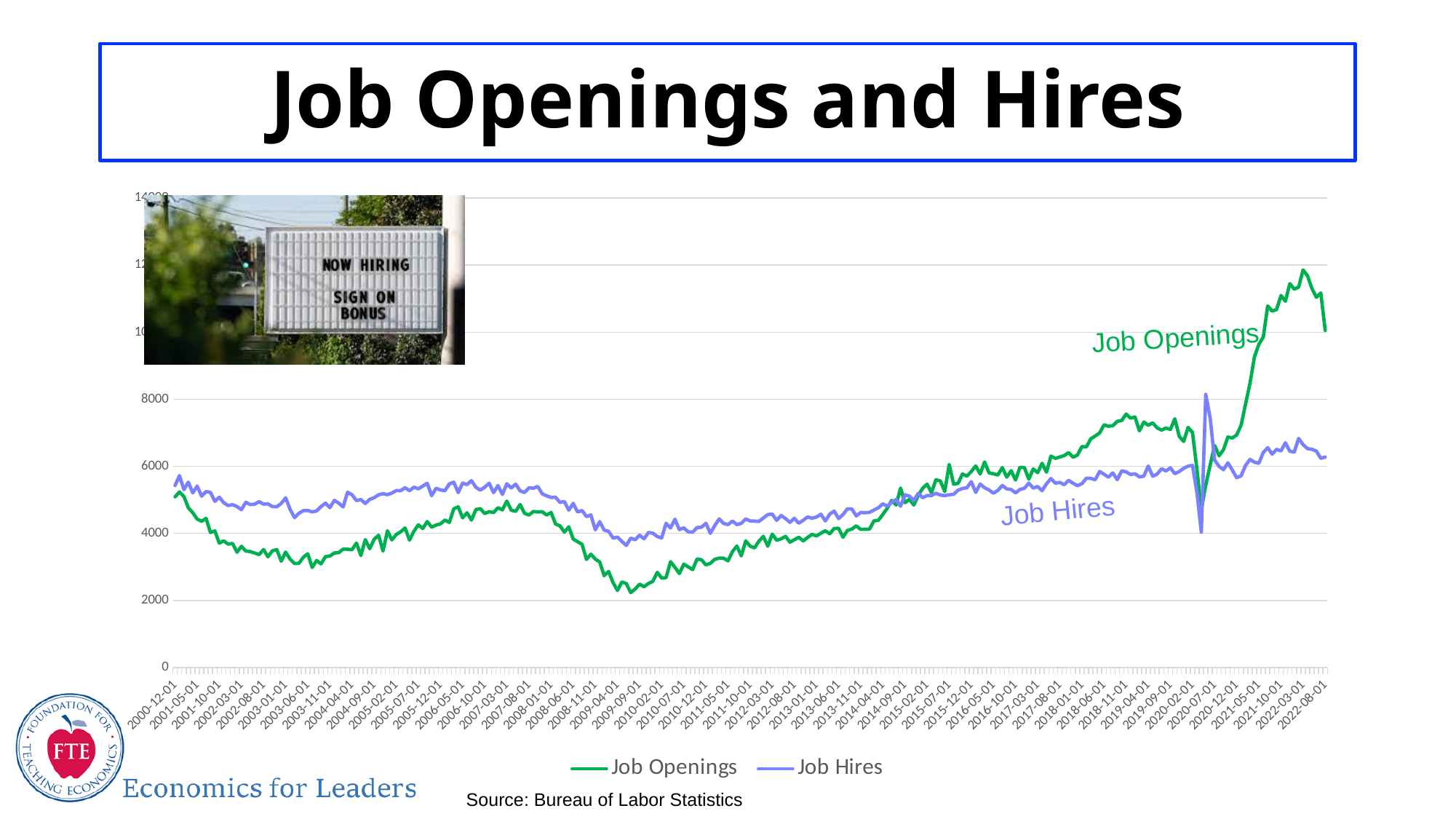
Does the Job Openings line rise or fall between 2020-07-01 and 2022-03-01? rise Is the value for Job Hires at 2000-12-01 greater or less than 4000? greater At 2009-09-01, which series has the higher value, Job Openings or Job Hires? Job Hires Is the value for Job Openings at 2009-09-01 greater or less than 4000? less At 2022-08-01, which series has the higher value, Job Openings or Job Hires? Job Openings Is the value for Job Hires at 2022-08-01 greater or less than 8000? less Which series reaches the highest value anywhere on the chart? Job Openings What colour is the Job Openings line? green How many series does the legend list? 2 What kind of chart is shown on the slide? line chart What are the two series named in the legend? Job Openings and Job Hires